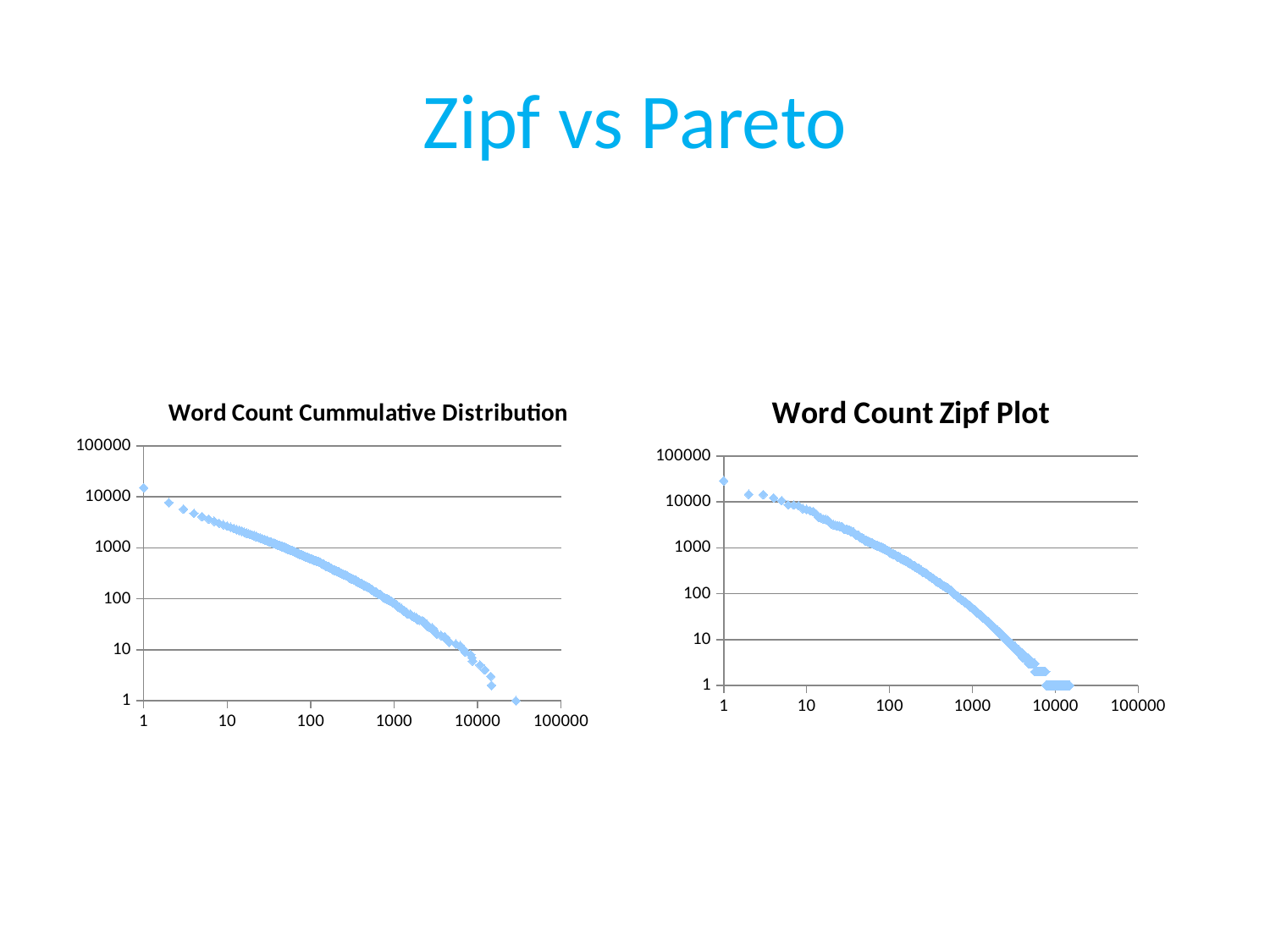
How many charts are shown on the slide? 2 In the "Word Count Zipf Plot", is the value of the first point at x = 1 greater or less than 10000? greater In the "Word Count Cummulative Distribution" chart, is the value of the first point at x = 1 greater or less than 10000? greater What is the title of the chart on the left of the slide? Word Count Cummulative Distribution What kind of chart is the "Word Count Zipf Plot"? scatter chart In the "Word Count Cummulative Distribution" chart, do the values rise or fall as the x axis increases? fall What is the highest value shown on the y axis of the "Word Count Zipf Plot"? 100000 In the "Word Count Zipf Plot", are the values of the points near x = 10000 greater or less than 10? less What kind of chart is the "Word Count Cummulative Distribution" chart? scatter chart In the "Word Count Zipf Plot", do the values rise or fall as the x axis increases? fall